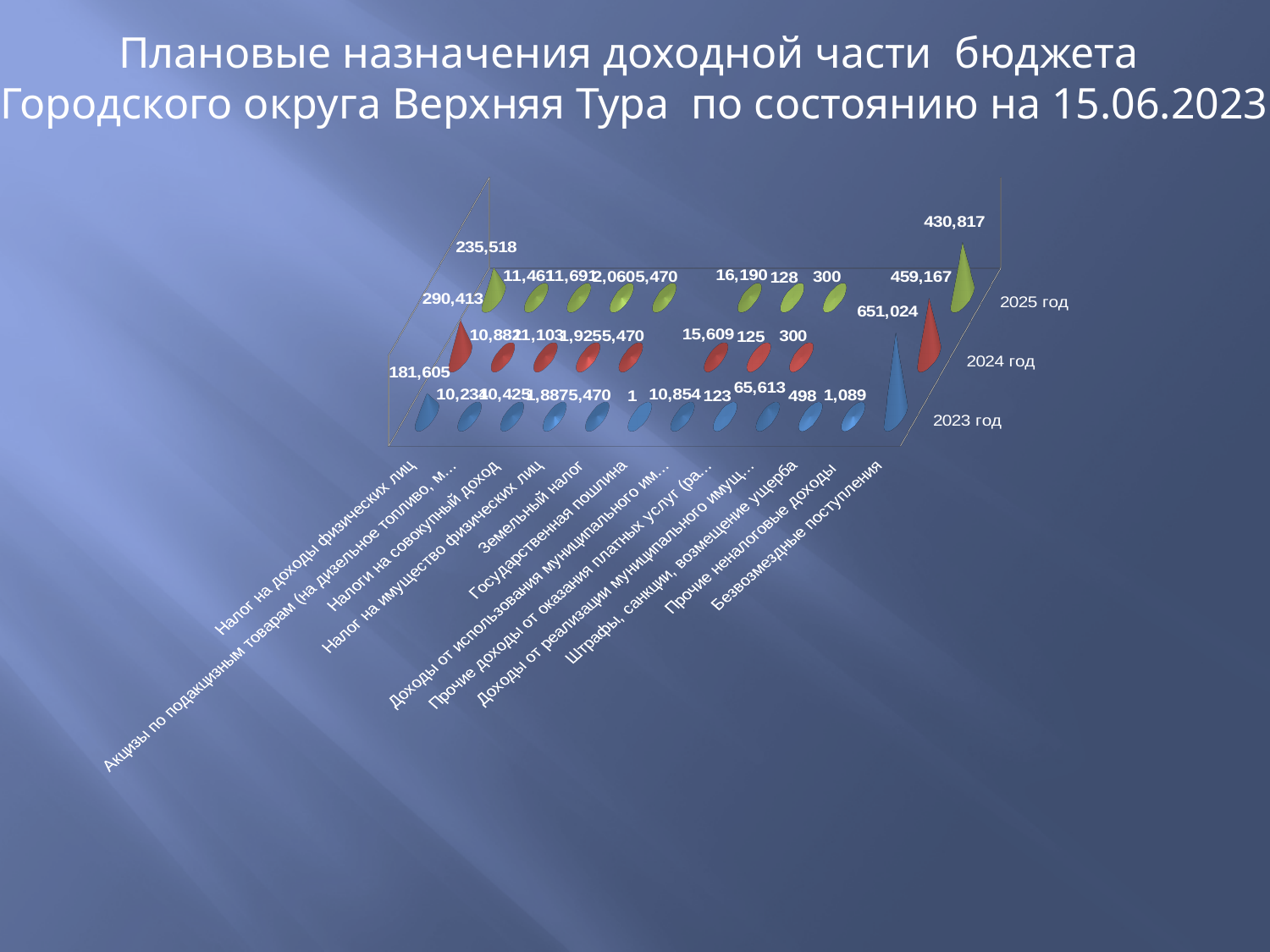
What is the 2023 год value for Штрафы, санкции, возмещение ущерба? 498 How many revenue categories are shown along the category axis? 12 For Налог на доходы физических лиц, which year has the larger value: 2024 год or 2025 год? 2024 год What is the 2023 год value for Безвозмездные поступления? 651,024 Which category has the highest value in the 2023 год series? Безвозмездные поступления What is the 2023 год value for Налог на доходы физических лиц? 181,605 What is the 2024 год value for Налог на доходы физических лиц? 290,413 What is the difference between the 2024 год and 2023 год values for Налог на доходы физических лиц? 108,808 How many years (series) are shown in the chart? 3 What is the 2025 год value for Безвозмездные поступления? 430,817 What is the difference between the 2023 год and 2024 год values for Безвозмездные поступления? 191,857 What date is given in the chart title for the planned budget revenue figures? 15.06.2023